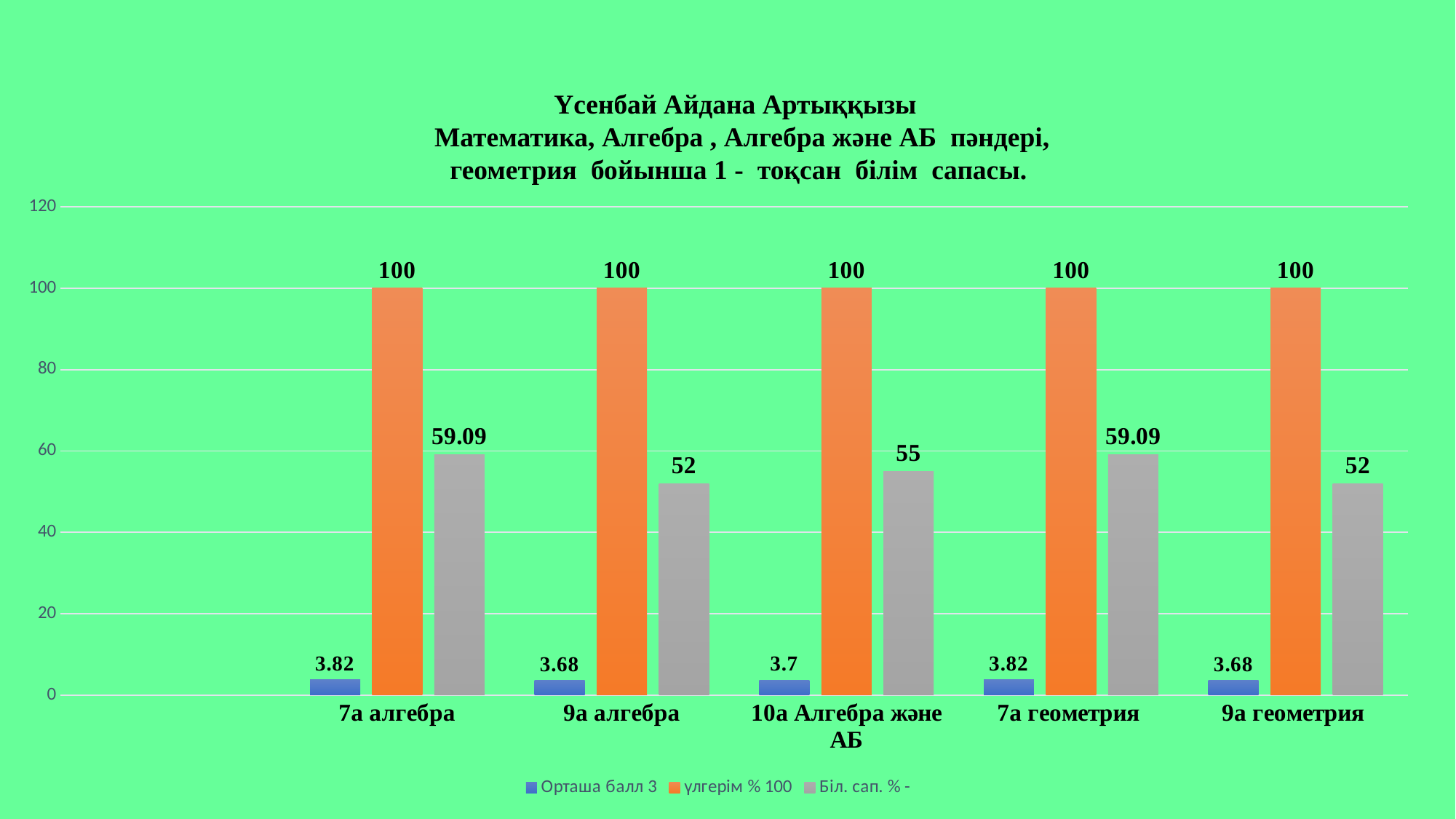
What is the difference between the 'Біл. сап. % -' values for 7а алгебра and 9а алгебра? 7.09 How many series does the legend list? 3 How many categories are shown on the x axis? 5 Which is larger: the 'Біл. сап. % -' value for 10а Алгебра және АБ or for 9а геометрия? 10а Алгебра және АБ What is the value of 'Біл. сап. % -' for 9а алгебра? 52 What kind of chart is shown on the slide? Bar chart What is the value of 'Орташа балл 3' for 10а Алгебра және АБ? 3.7 Which category has the lowest value for 'Біл. сап. % -'? 9а алгебра and 9а геометрия (both 52) What colour are the bars for the 'үлгерім % 100' series? Orange What is the value of 'Біл. сап. % -' for 7а алгебра? 59.09 What is the value of 'үлгерім % 100' for 9а геометрия? 100 Which category has the highest value for 'Орташа балл 3'? 7а алгебра and 7а геометрия (both 3.82)